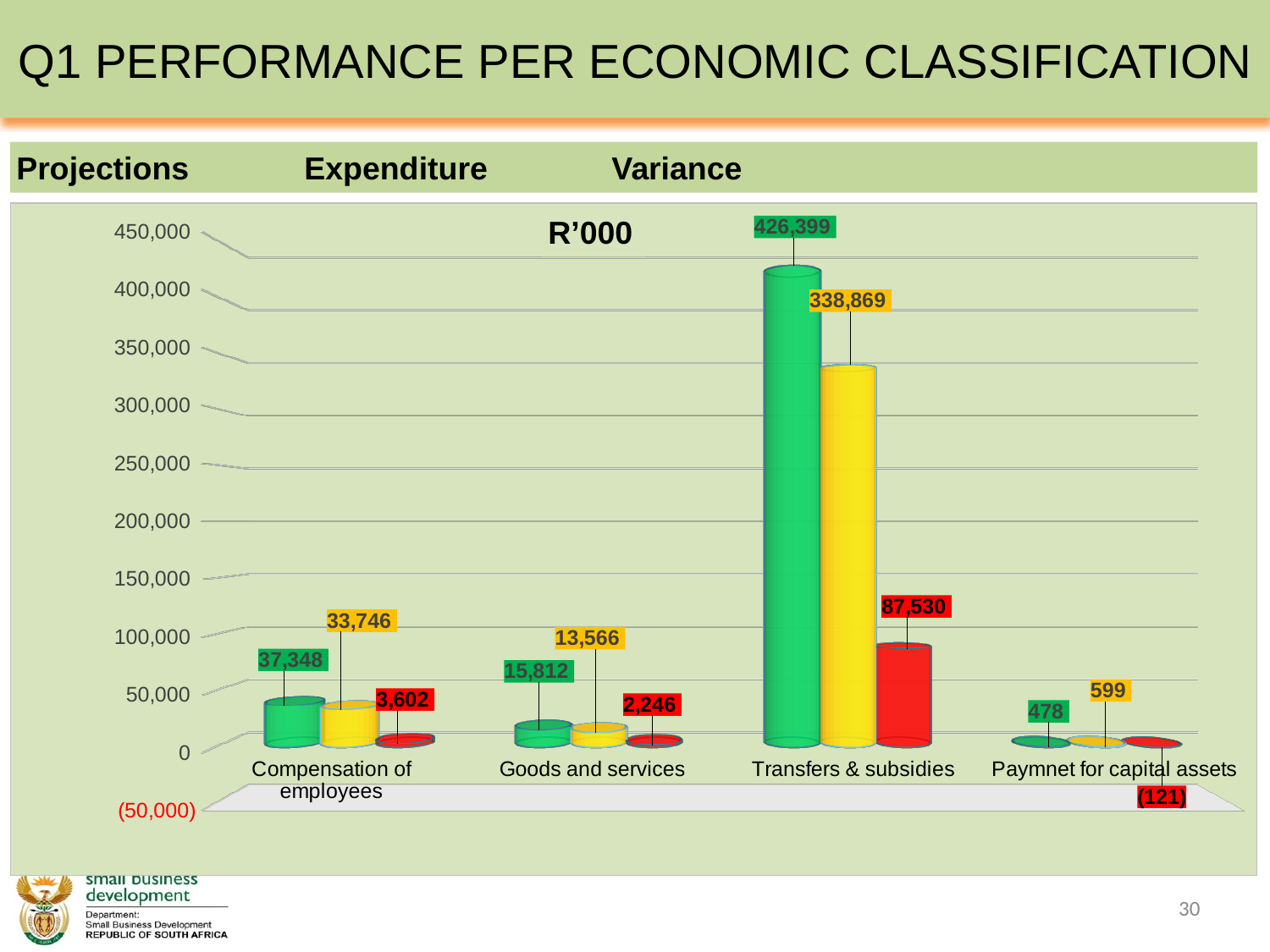
Which category has the highest Projections value? Transfers & subsidies What is the Variance value for Paymnet for capital assets? (121) Which is larger for Paymnet for capital assets: the Projections value or the Expenditure value? Expenditure What is the difference between the Projections and Expenditure values for Transfers & subsidies? 87,530 Is the Expenditure value for Transfers & subsidies greater or less than 300,000? greater Which category has the lowest Expenditure value? Paymnet for capital assets How many series does the chart show? 3 How many categories are shown on the x axis? 4 What unit is stated on the chart? R'000 What is the Projections value for Transfers & subsidies? 426,399 What is the Variance value for Goods and services? 2,246 What is the Expenditure value for Compensation of employees? 33,746